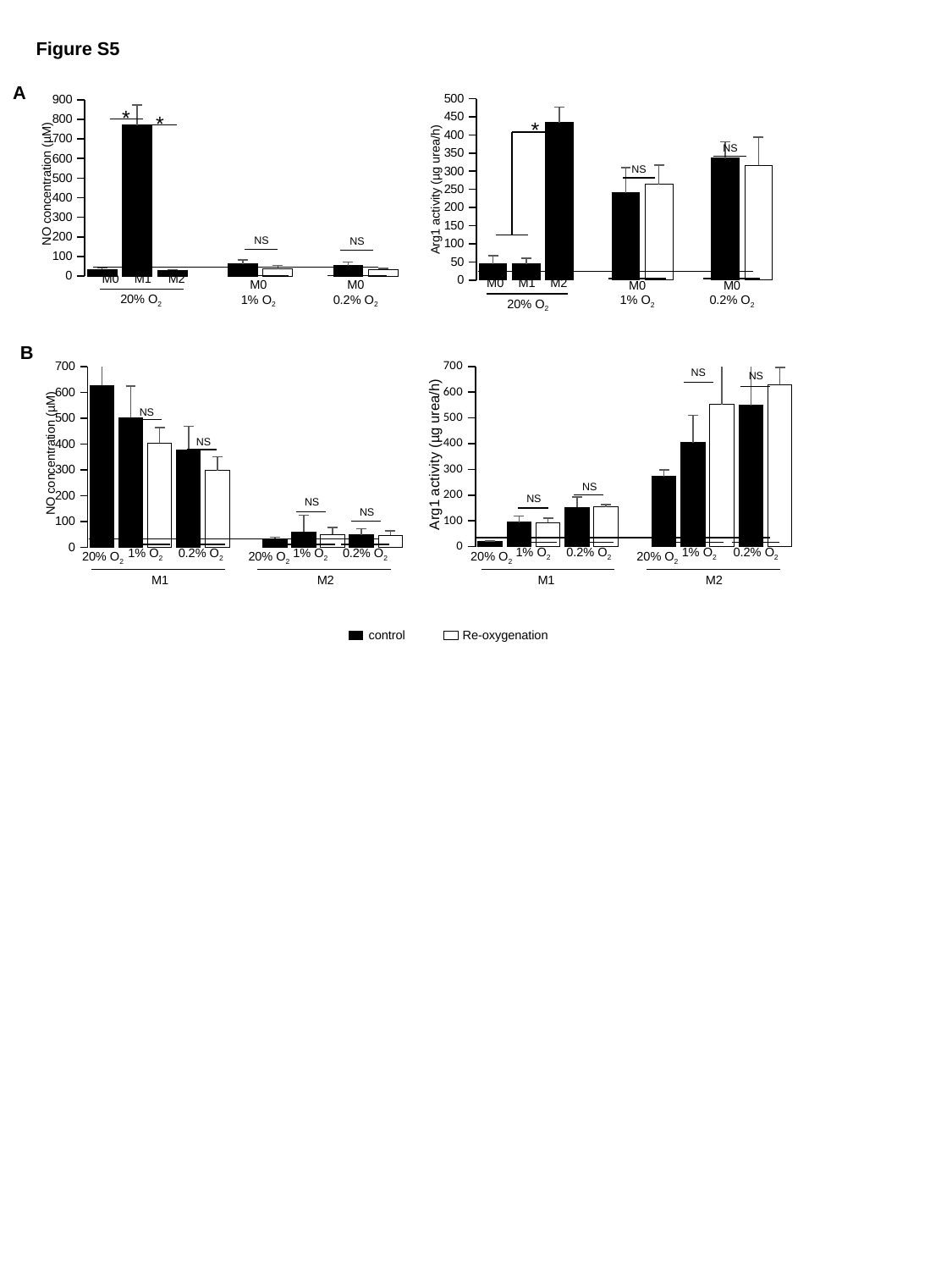
In the panel B NO concentration chart (left), which is larger at 20% O2: M1 or M2? M1 In the panel A Arg1 activity chart (right), is the value for M2 at 20% O2 greater or less than 400? greater In the panel A Arg1 activity chart (right), which bar is the highest? M2 at 20% O2 In the panel B Arg1 activity chart (right), is the value for M2 at 20% O2 greater or less than 200? greater In the panel B NO concentration chart (left), for M1 at 1% O2, which is larger: control or Re-oxygenation? control How many series does the legend at the bottom of the slide list? 2 In the panel A NO concentration chart (left), is the value for M1 at 20% O2 greater or less than 700? greater In the panel A NO concentration chart (left), which bar is the highest? M1 at 20% O2 What is the y-axis label of the panel A chart on the right? Arg1 activity (µg urea/h) What kind of chart is used in panel A (left, NO concentration)? bar chart